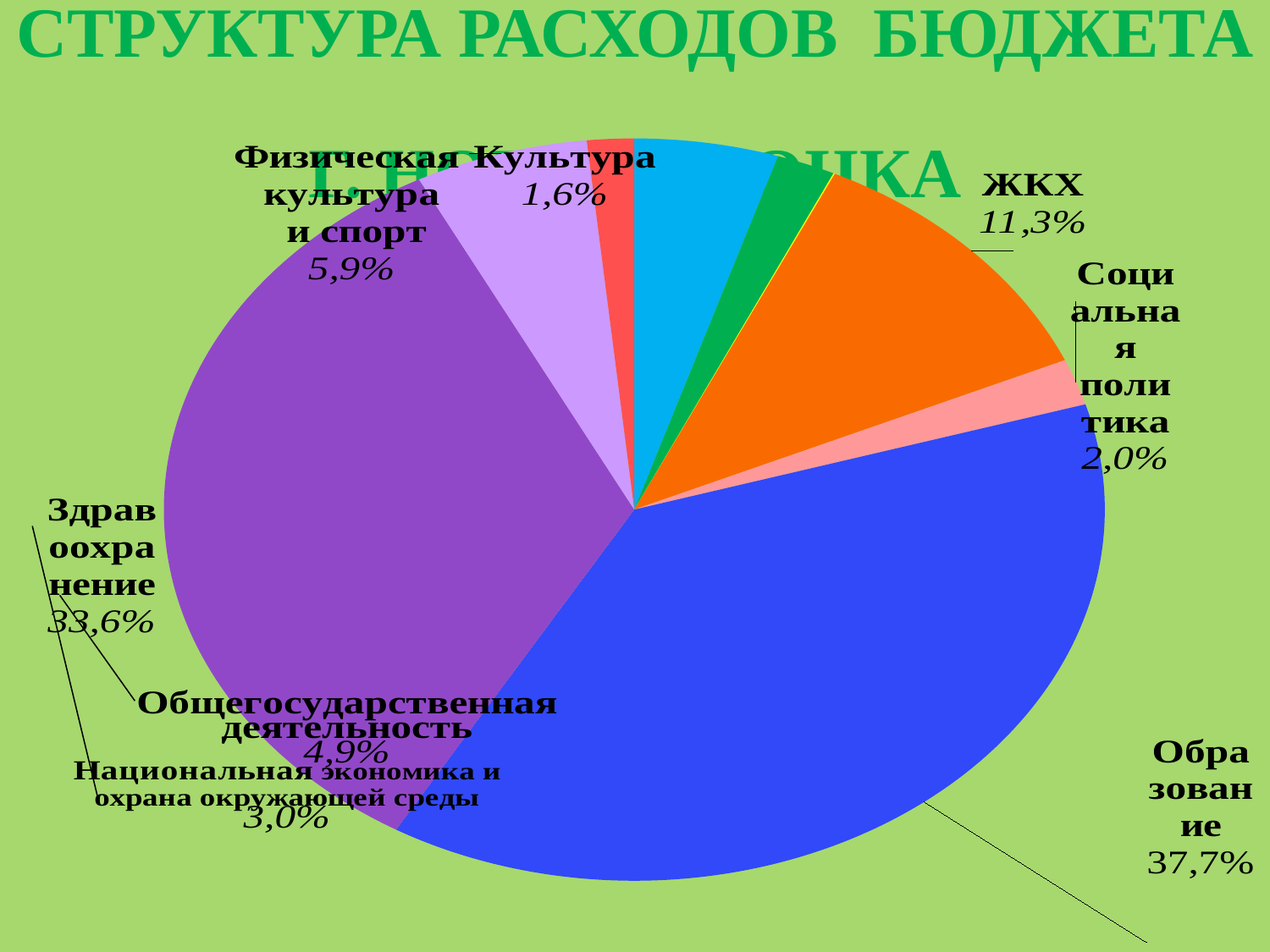
What share of budget expenditure goes to Образование? 37,7% Which category has the smallest share of the budget expenditure? Культура What percentage is shown for Социальная политика? 2,0% What percentage is shown for Национальная экономика и охрана окружающей среды? 3,0% By how many percentage points does Образование exceed Здравоохранение? 4,1 What share of budget expenditure goes to Здравоохранение? 33,6% Which is larger, the share for ЖКХ or the share for Общегосударственная деятельность? ЖКХ What share of budget expenditure goes to ЖКХ? 11,3% What percentage is shown for Физическая культура и спорт? 5,9% What kind of chart is shown on the slide? Pie chart How many slices does the pie chart have? 8 Which category has the largest share of the budget expenditure? Образование